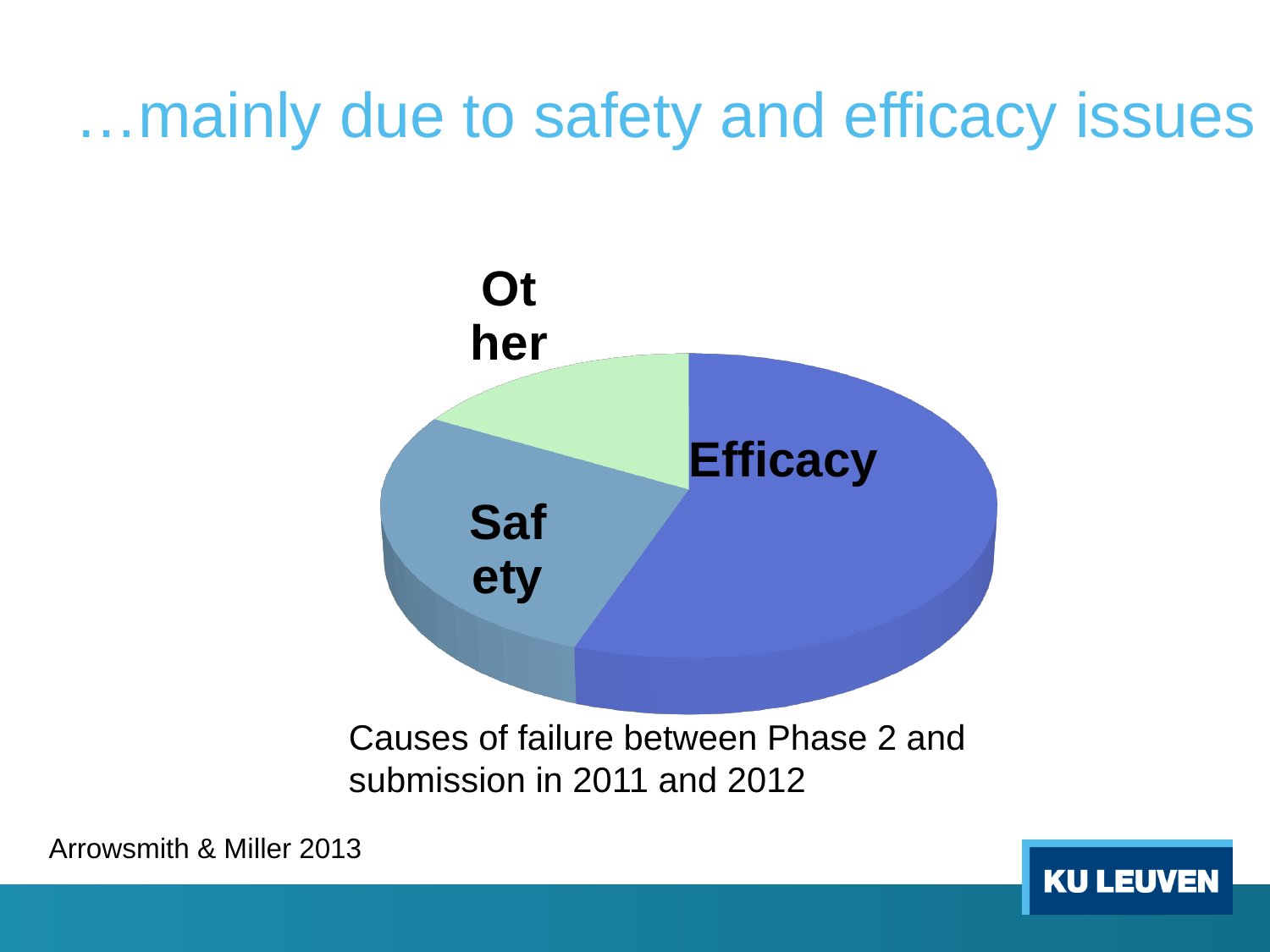
Which slice is larger, Efficacy or Safety? Efficacy What does the caption below the pie chart say the chart shows? Causes of failure between Phase 2 and submission in 2011 and 2012 What kind of chart is shown on the slide? Pie chart Which cause of failure has the largest slice in the pie chart? Efficacy What are the three categories labelled on the pie chart? Efficacy, Safety, Other How many slices does the pie chart have? 3 Does the Efficacy slice take up more or less than half of the pie? More Which slice is larger, Safety or Other? Safety Which cause of failure has the smallest slice in the pie chart? Other